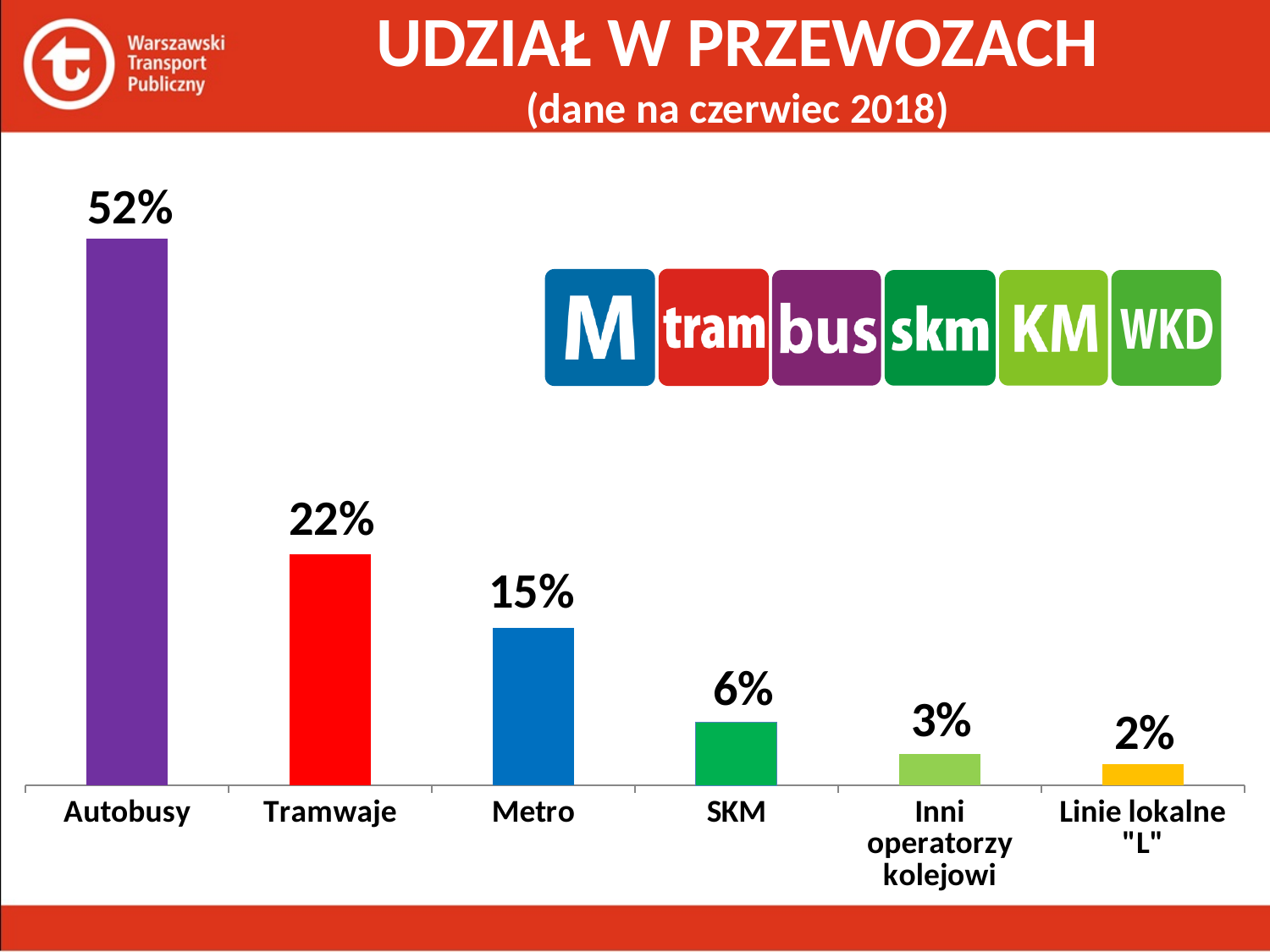
What is the value for Tramwaje? 22% Which category has the lowest value? Linie lokalne "L" What is the value for Inni operatorzy kolejowi? 3% What is the value for Autobusy? 52% What kind of chart is shown on the slide? Bar chart What is the value for Metro? 15% What is the difference between the values for Autobusy and Tramwaje? 30% Which is larger, the value for SKM or the value for Inni operatorzy kolejowi? SKM Which category has the highest value? Autobusy How many categories are shown on the chart? 6 Do the values rise or fall from left to right along the x axis? Fall What is the difference between the values for Metro and SKM? 9%